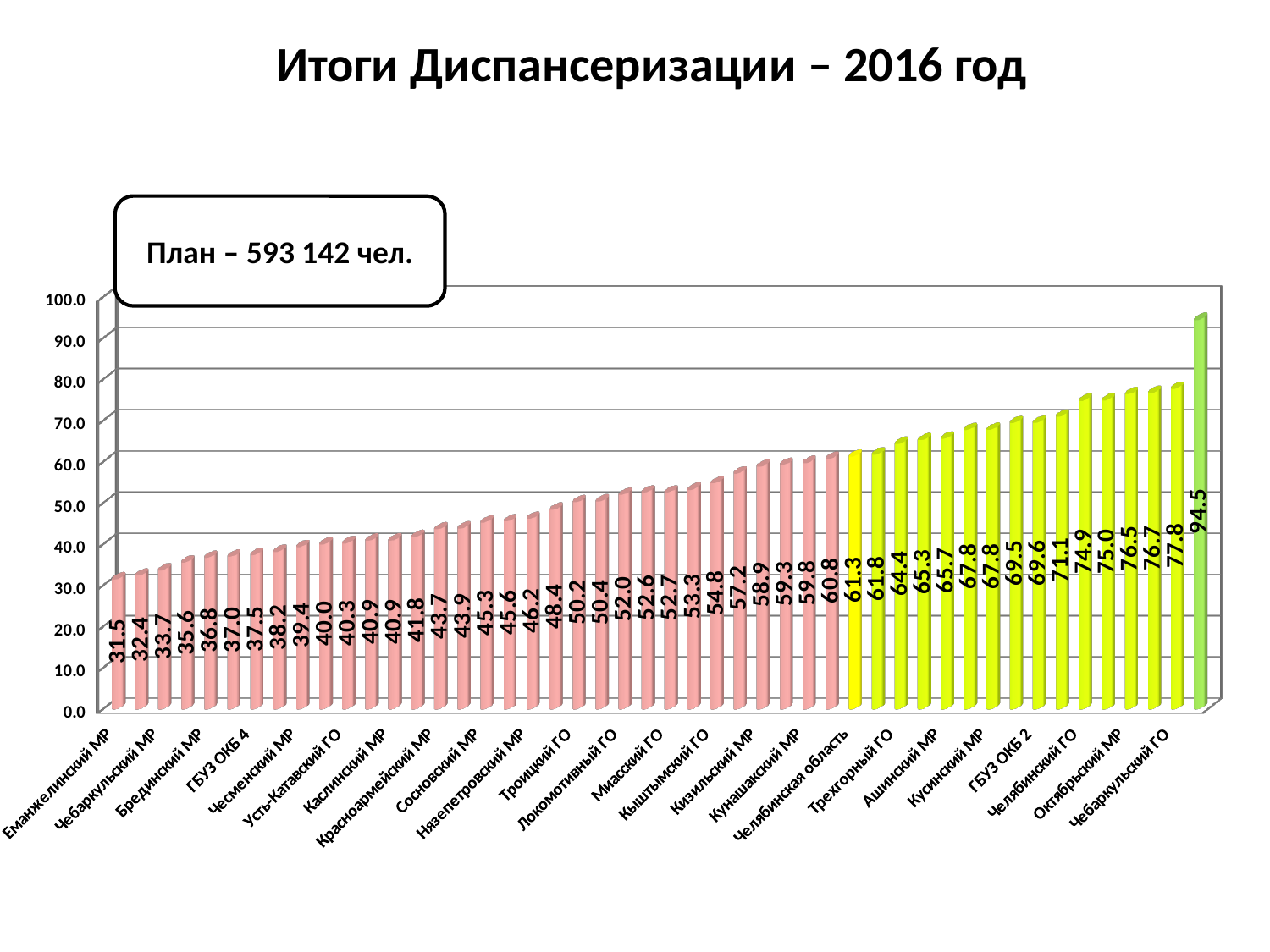
What is the title of the slide? Итоги Диспансеризации – 2016 год Is the value for Челябинская область greater or less than 60.0? greater What is the value for Еманжелинский МР? 31.5 What is the value for Челябинская область? 61.3 What kind of chart is shown on the slide? bar chart What is the highest value shown on the chart? 94.5 Which is larger, the value for Чебаркульский ГО or the value for Еманжелинский МР? Чебаркульский ГО How many bars are plotted on the chart? 48 What plan figure is shown in the text box on the slide? План – 593 142 чел. Which category has the lowest value? Еманжелинский МР Do the values rise or fall from left to right along the x axis? rise What is the difference between the highest value (94.5) and the lowest value (31.5)? 63.0